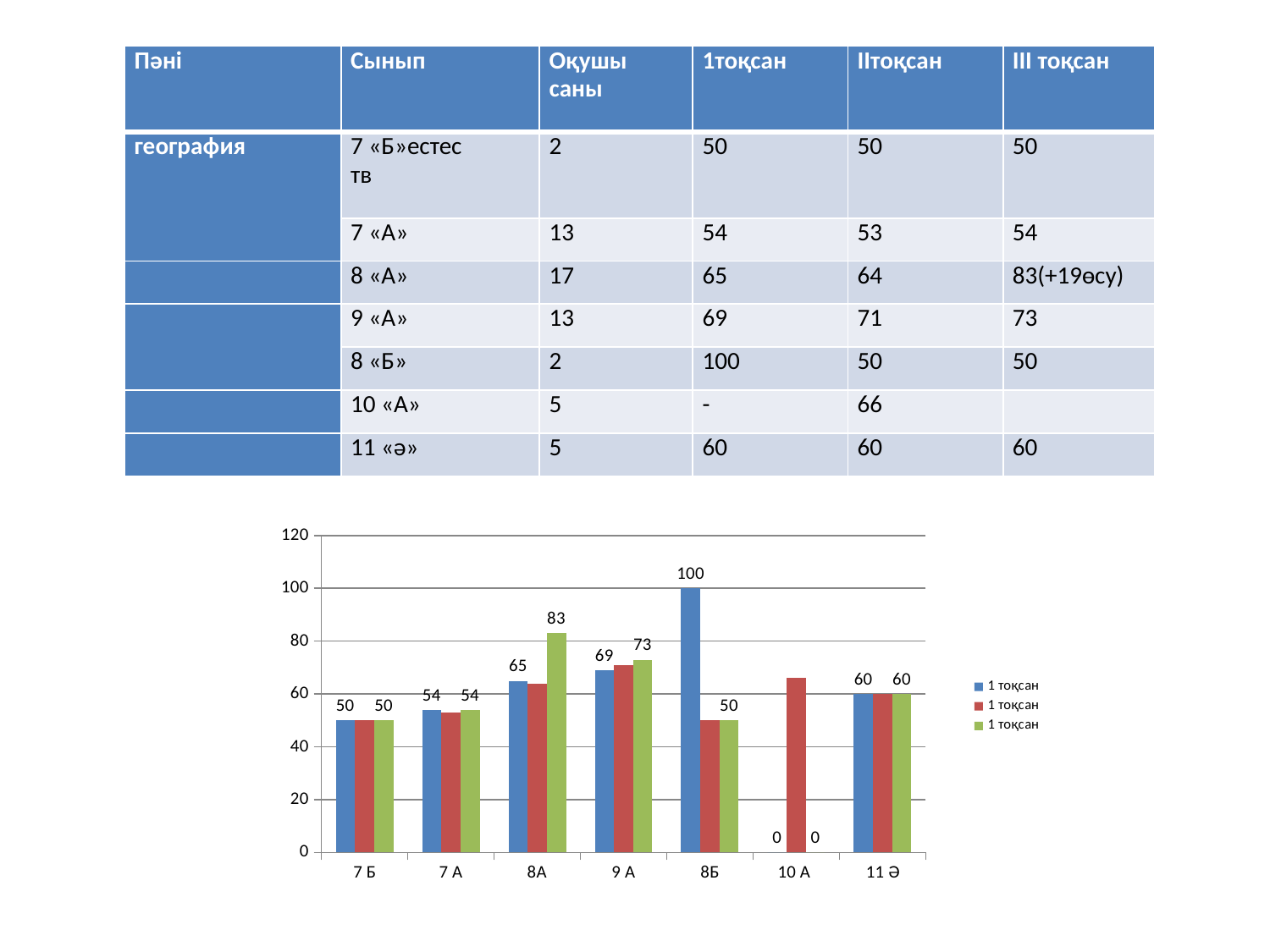
What kind of chart is shown on the slide? bar chart Which category has the lowest green bar? 10 А How many series does the chart's legend list? 3 What is the value of the blue bar for 10 А? 0 What is the value of the green bar for 9 А? 73 How many categories are shown on the x axis of the chart? 7 For 9 А, which is larger: the blue bar or the green bar? green bar What is the difference between the green bar and the blue bar for 8А? 18 What is the value of the green bar for 8А? 83 Is the value of the red bar for 10 А greater or less than 80? less What is the value of the blue bar for 8Б? 100 Which category has the highest blue bar? 8Б